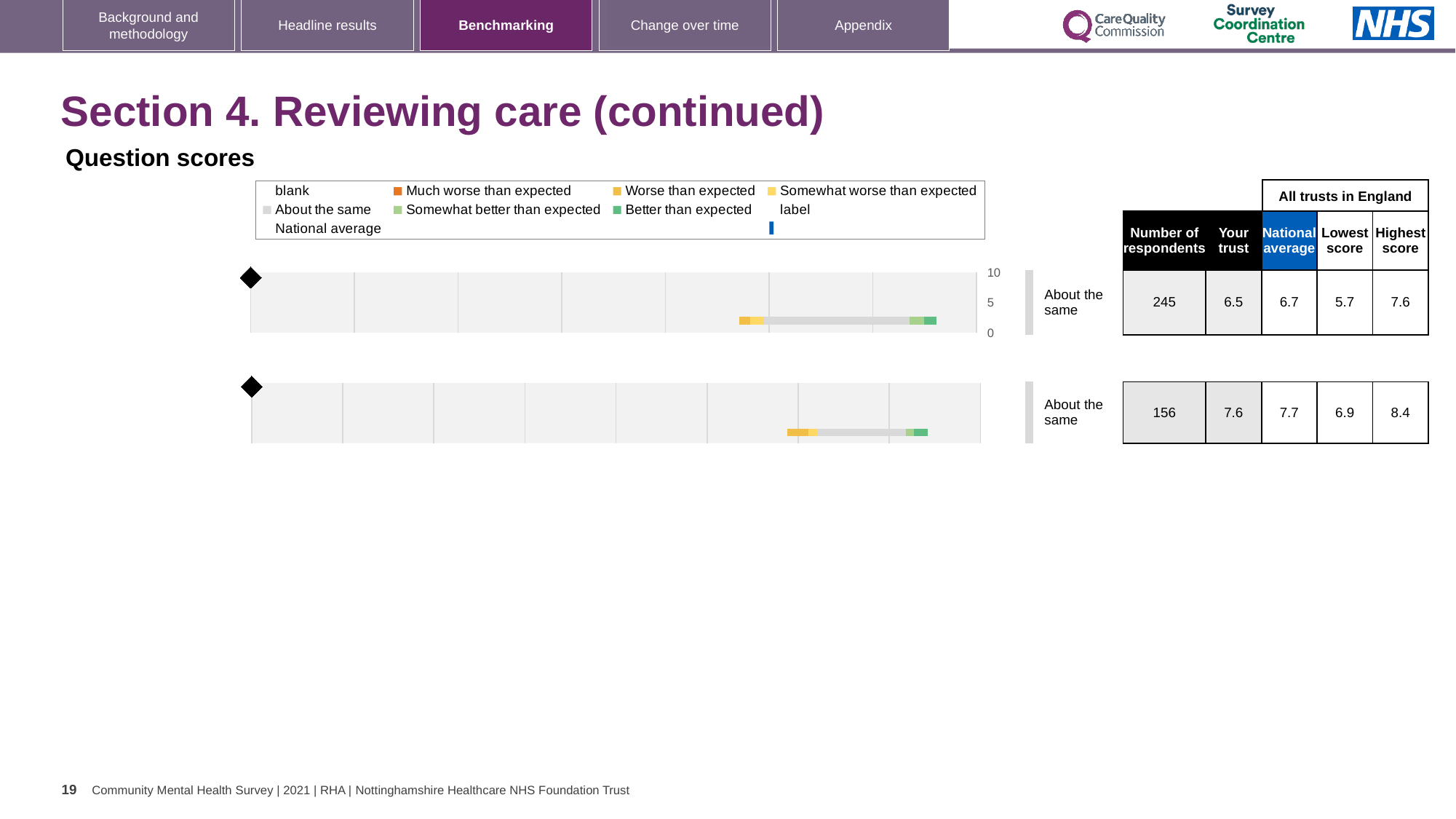
How many question-score charts are shown on the slide? 2 What benchmark category label is shown next to both charts? About the same For the top chart, which is larger: the 'Your trust' score or the national average? National average For the bottom chart, what is the difference between the highest score and the lowest score? 1.5 For the top chart, what is the 'Your trust' score shown in the table? 6.5 Which chart has more respondents, the top chart or the bottom chart? Top chart What kind of chart is used to show the question scores on this slide? bar chart For the bottom chart, how many respondents are listed in the table? 156 For the top chart, what is the difference between the national average and the 'Your trust' score? 0.2 For the top chart, what is the national average shown in the table? 6.7 For the bottom chart, what is the highest score among all trusts in England? 8.4 For the top chart, what is the lowest score among all trusts in England? 5.7